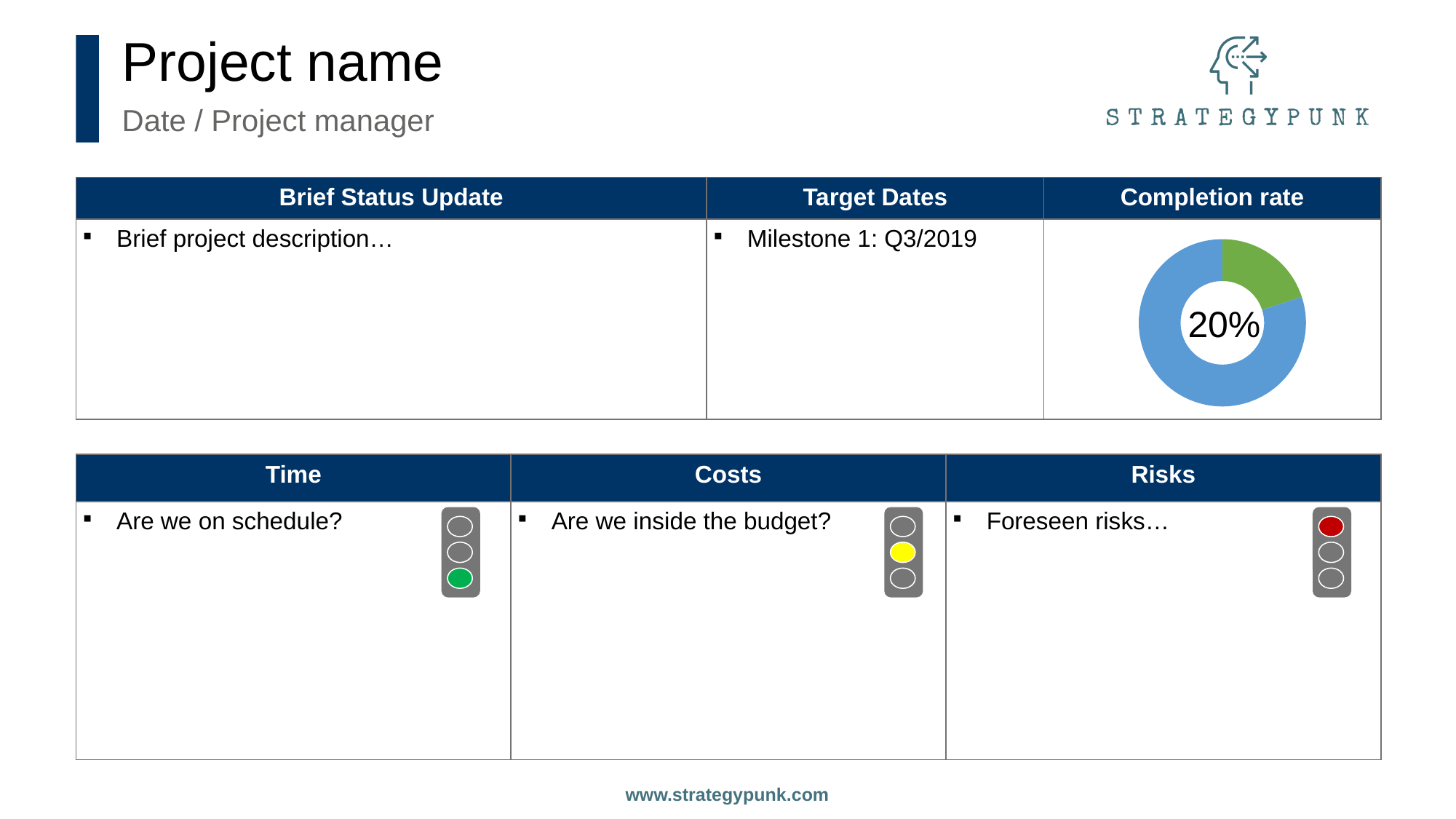
What share of the donut chart does the green slice represent? 20% What is the title of the table column that contains the donut chart? Completion rate Is the completion rate shown in the donut chart greater or less than 50%? less How many slices does the Completion rate donut chart have? 2 What kind of chart is shown under the Completion rate heading? Donut chart What completion rate value is printed in the centre of the donut chart? 20% What colour is the smaller slice of the Completion rate donut chart? Green In the Completion rate donut chart, which slice is larger, the blue one or the green one? Blue